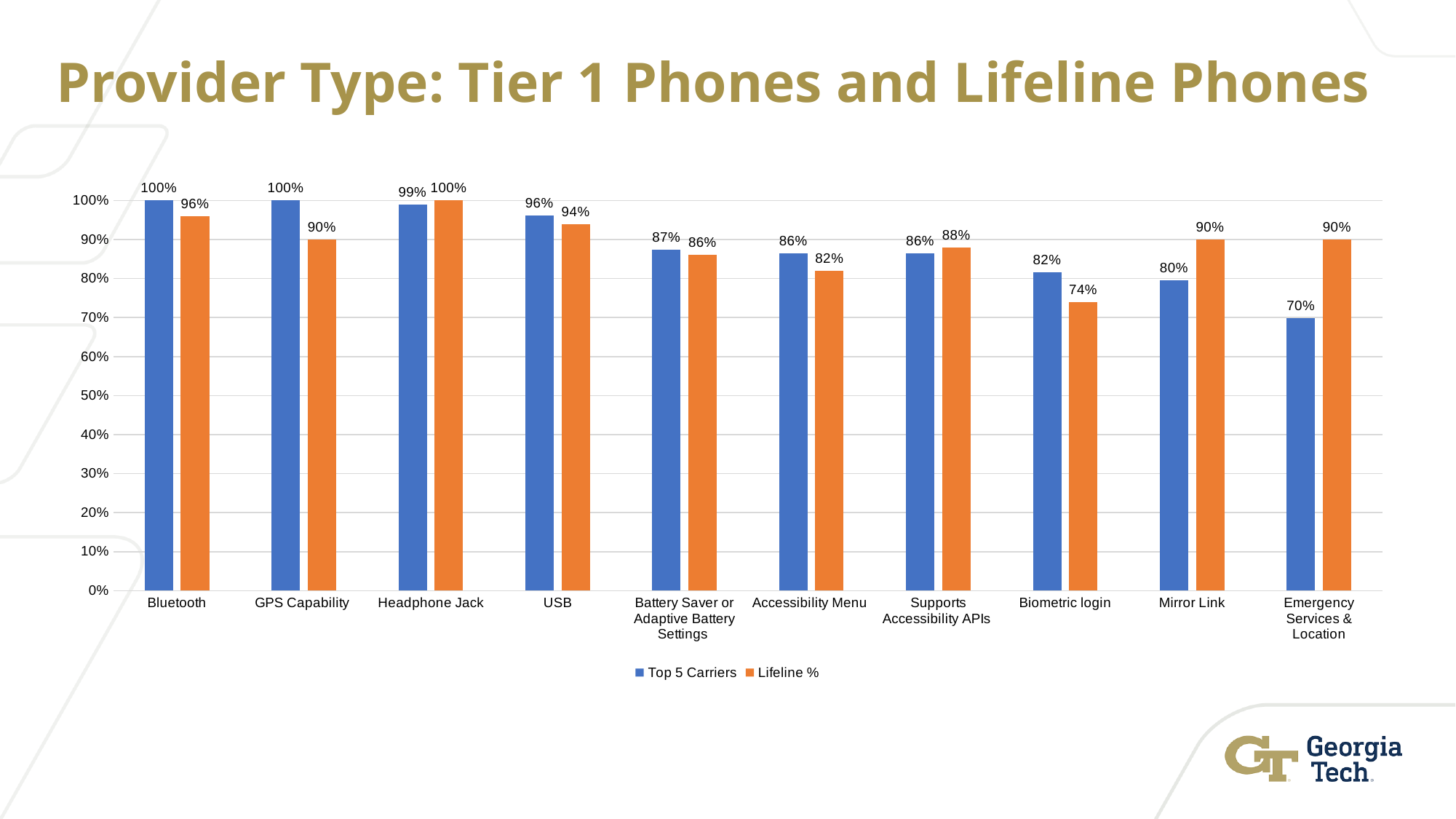
What is the Top 5 Carriers value for Bluetooth? 100% What is the Top 5 Carriers value for Emergency Services & Location? 70% For Mirror Link, which is larger: the Top 5 Carriers value or the Lifeline % value? Lifeline % What is the Lifeline % value for Biometric login? 74% What is the Lifeline % value for GPS Capability? 90% Which category has the lowest Lifeline % value? Biometric login How many categories are shown on the x axis? 10 Which category has the lowest Top 5 Carriers value? Emergency Services & Location How many series does the legend list? 2 What is the title of the slide? Provider Type: Tier 1 Phones and Lifeline Phones What kind of chart is shown on the slide? Bar chart What is the difference between the Top 5 Carriers and Lifeline % values for Emergency Services & Location? 20%